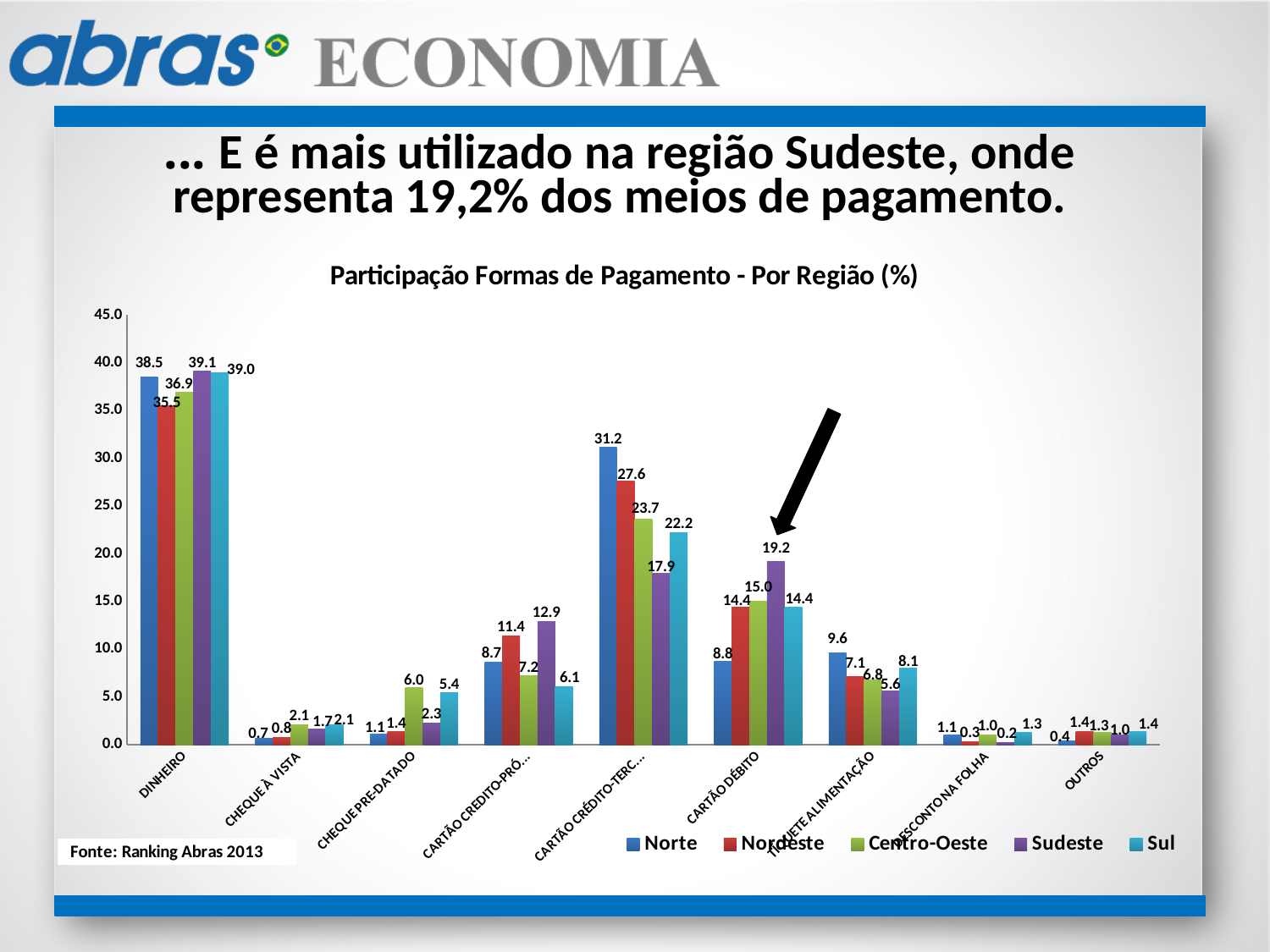
What is the difference between the Sudeste and Sul values in the CARTÃO CREDITO-PRÓ... category? 6.8 What is the value for Centro-Oeste in the CHEQUE PRE-DATADO category? 6.0 What kind of chart is shown on the slide? Bar chart What is the value for Sudeste in the CARTÃO DÉBITO category? 19.2 Which region has the highest value in the DINHEIRO category? Sudeste How many series does the legend list? 5 What is the value for Norte in the CARTÃO CRÉDITO-TERC... category? 31.2 What is the title of the chart? Participação Formas de Pagamento - Por Região (%) What is the difference between the Norte and Sudeste values in the CARTÃO CRÉDITO-TERC... category? 13.3 Which region has the lowest value in the CARTÃO DÉBITO category? Norte How many payment-method categories are shown on the x axis? 9 Which is larger in the TIQUETE ALIMENTAÇÃO category: Norte or Sul? Norte